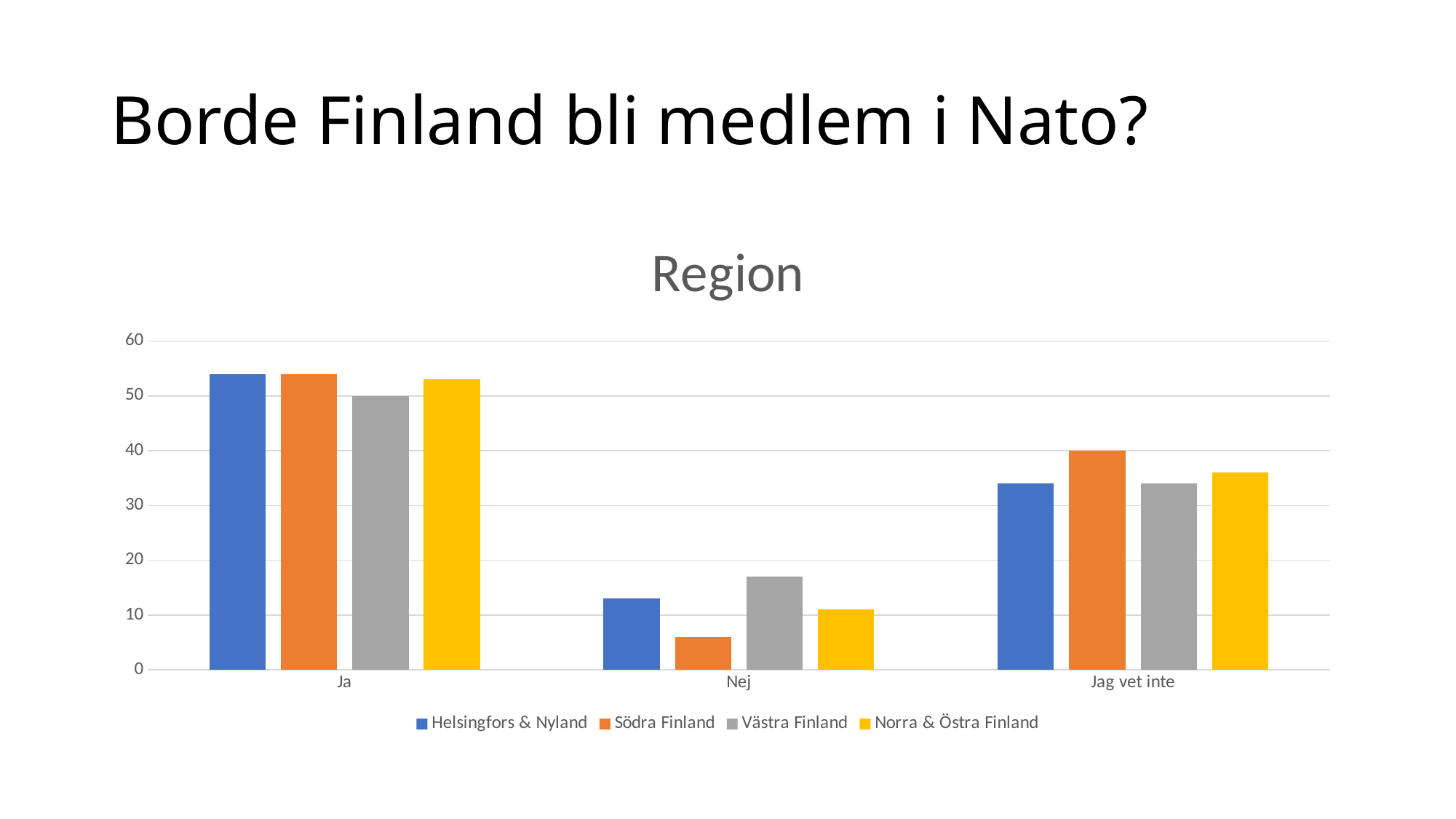
Is the value for Södra Finland in the Nej category greater or less than 10? less How many categories are shown on the x axis? 3 What is the title of the chart? Region Which series has the highest value for Nej? Västra Finland What kind of chart is shown on the slide? bar chart Is the value for Helsingfors & Nyland in the Ja category greater or less than 50? greater Is the value for Norra & Östra Finland in the Jag vet inte category greater or less than 40? less Which series has the lowest value for Ja? Västra Finland Which series has the highest value for Jag vet inte? Södra Finland Which colour represents Norra & Östra Finland in the chart? yellow How many series does the legend list? 4 Which series has the lowest value for Nej? Södra Finland